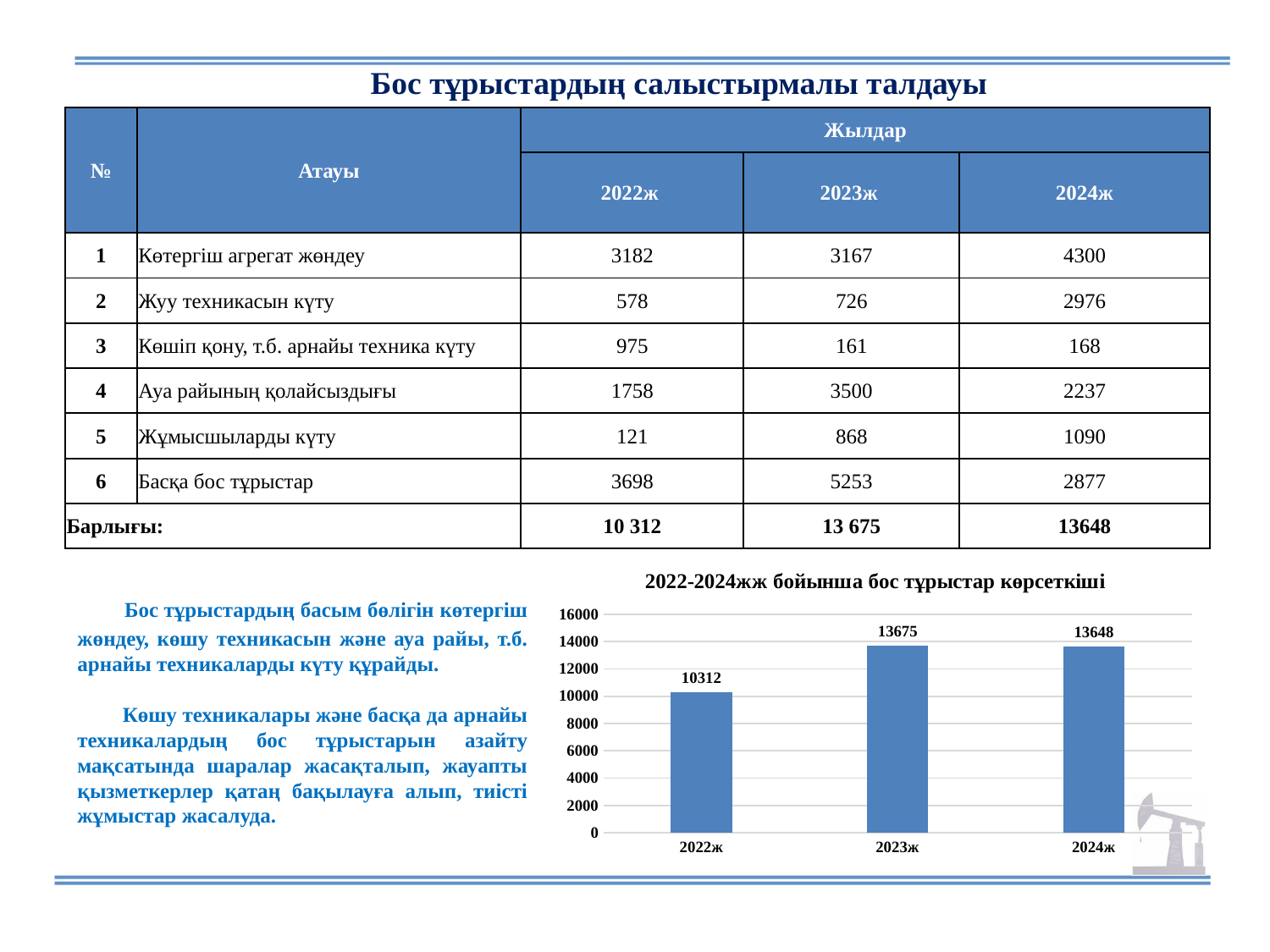
What is the value for 2023ж in the chart? 13675 How many bars are shown in the chart? 3 What is the title of the chart? 2022-2024жж бойынша бос тұрыстар көрсеткіші Which is larger in the chart, the value for 2022ж or the value for 2024ж? 2024ж What kind of chart is shown on the slide? bar chart What is the difference between the values for 2023ж and 2024ж in the chart? 27 Which year has the lowest value in the chart? 2022ж What is the difference between the values for 2023ж and 2022ж in the chart? 3363 Is the value for 2022ж greater or less than 10000? greater Which year has the highest value in the chart? 2023ж What is the value for 2024ж in the chart? 13648 What is the value for 2022ж in the chart? 10312